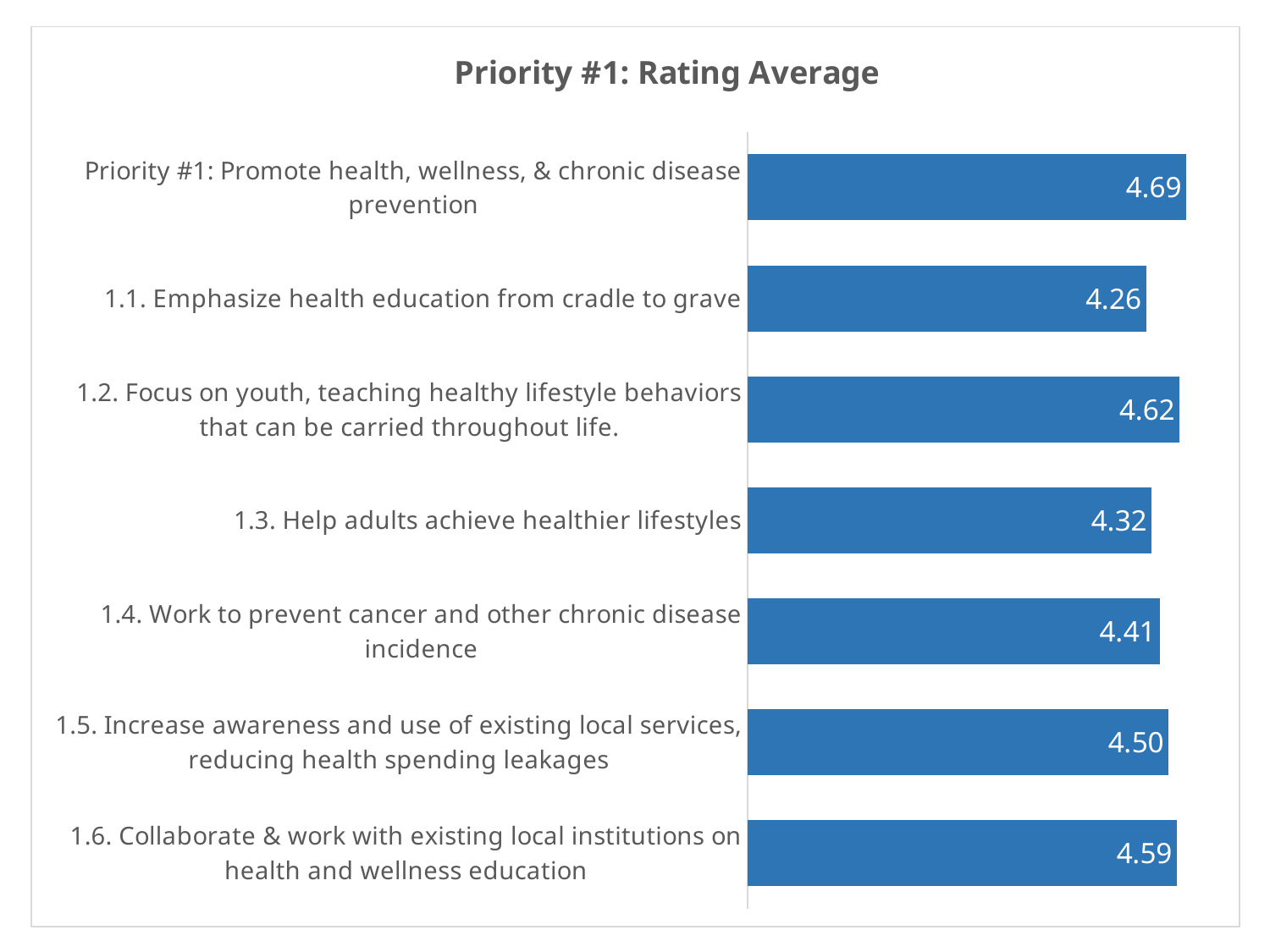
What is the title of the chart? Priority #1: Rating Average Which category has the highest rating average? Priority #1: Promote health, wellness, & chronic disease prevention What is the rating average for "1.5. Increase awareness and use of existing local services, reducing health spending leakages"? 4.50 Which category has the lowest rating average? 1.1. Emphasize health education from cradle to grave What is the rating average for "1.3. Help adults achieve healthier lifestyles"? 4.32 Which has a higher rating average: "1.4. Work to prevent cancer and other chronic disease incidence" or "1.6. Collaborate & work with existing local institutions on health and wellness education"? 1.6. Collaborate & work with existing local institutions on health and wellness education What kind of chart is shown on the slide? Bar chart How many categories are shown in the chart? 7 What is the difference between the highest and lowest rating averages in the chart? 0.43 What is the rating average for "Priority #1: Promote health, wellness, & chronic disease prevention"? 4.69 What is the difference between the rating average for "1.2. Focus on youth, teaching healthy lifestyle behaviors that can be carried throughout life." and "1.3. Help adults achieve healthier lifestyles"? 0.30 What is the rating average for "1.1. Emphasize health education from cradle to grave"? 4.26